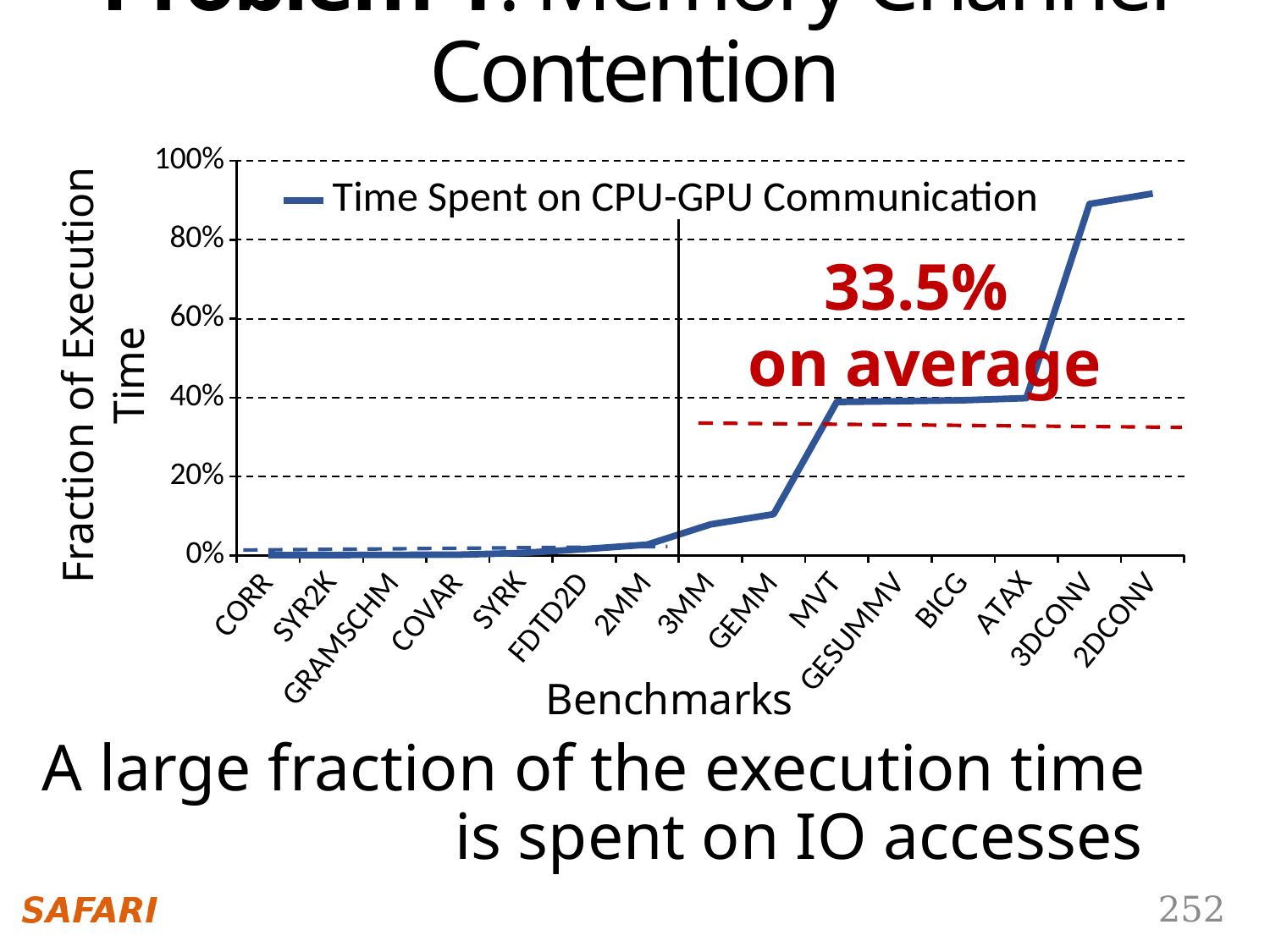
What kind of chart is shown on the slide? line chart Is the value for 2DCONV greater or less than 80%? greater What is the average value annotated on the chart? 33.5% Do the values rise or fall moving from left to right along the x axis? rise What is the name of the series shown in the legend? Time Spent on CPU-GPU Communication How many benchmarks are plotted along the x axis? 15 Which benchmark has the highest fraction of execution time spent on CPU-GPU communication? 2DCONV How many series does the legend list? 1 Which has a larger value, 2DCONV or GEMM? 2DCONV Is the value for 3DCONV greater or less than 80%? greater Is the value for CORR greater or less than 20%? less